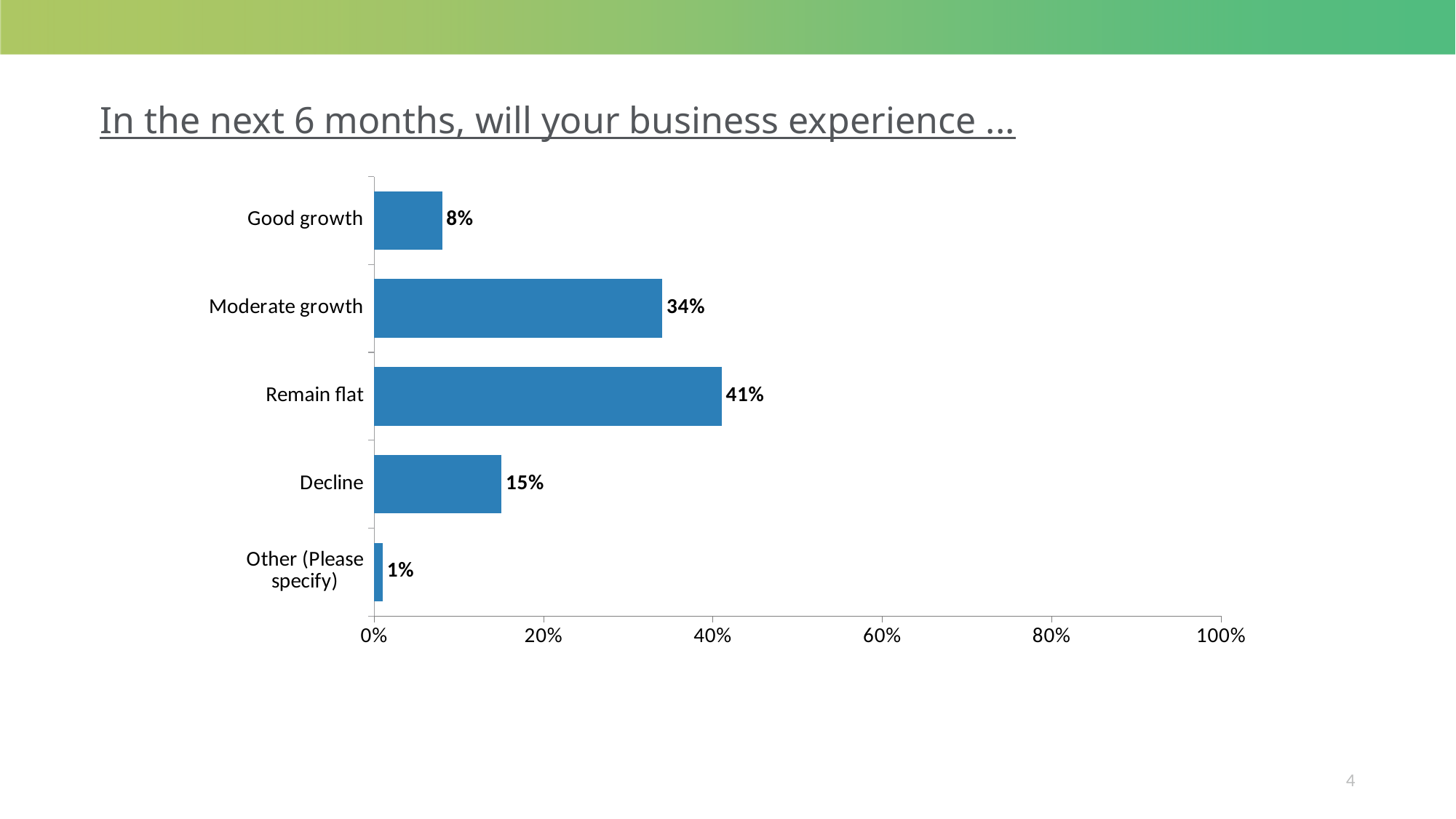
What is the value for Other (Please specify)? 1% How many categories are shown in the chart? 5 What kind of chart is shown on the slide? Bar chart Is the value for Remain flat greater or less than 40%? greater What is the difference between the values for Remain flat and Moderate growth? 7% What is the value for Moderate growth? 34% Which category has the lowest value? Other (Please specify) What percentage of respondents expect a Decline? 15% What is the value for Remain flat? 41% What percentage of respondents expect good growth in the next 6 months? 8% Which category has the highest value? Remain flat Which is larger, the value for Decline or the value for Good growth? Decline